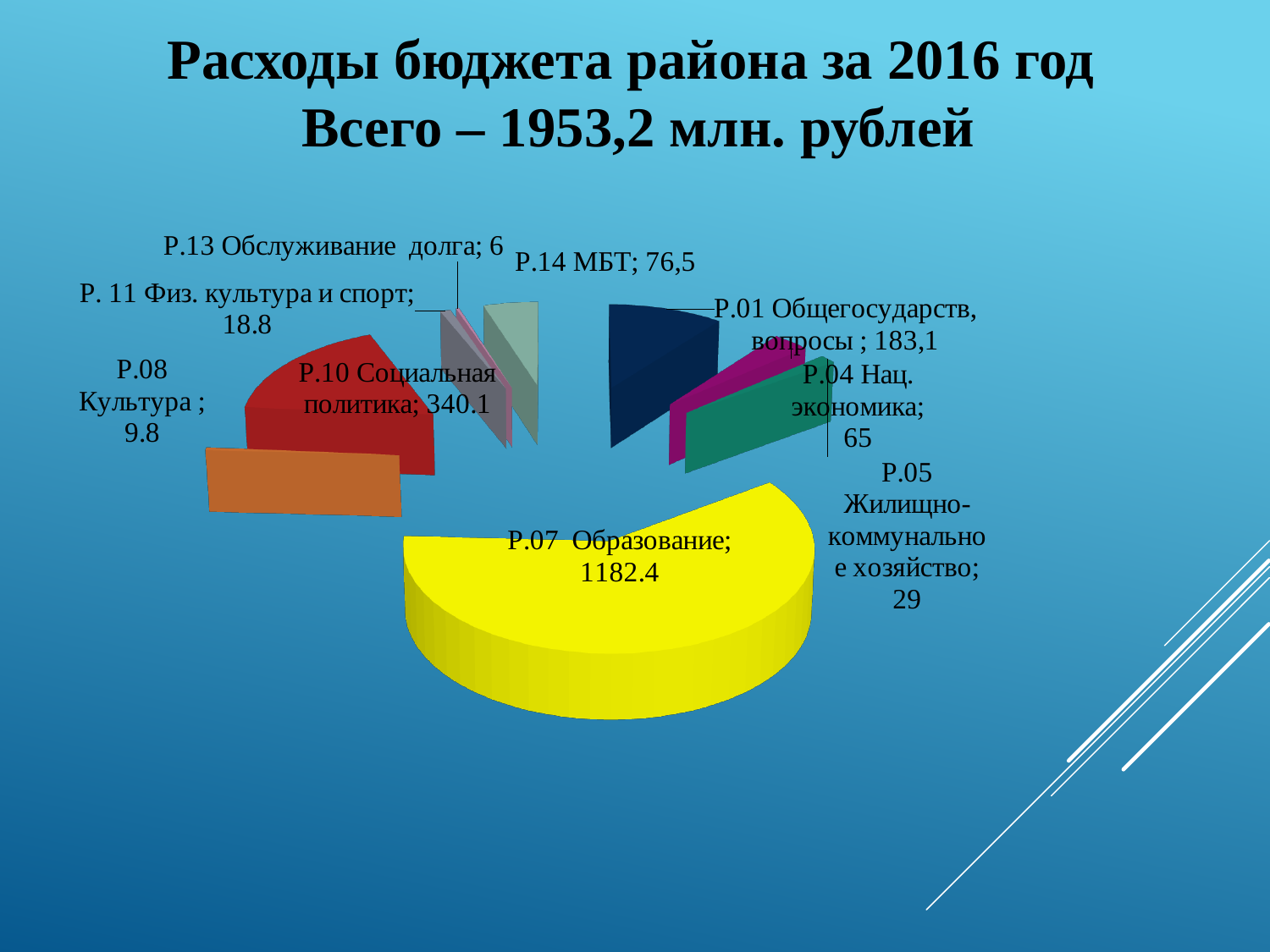
Which category has the smallest value? Р.13 Обслуживание долга What type of chart is shown on the slide? pie chart Which category has the largest slice of the pie? Р.07 Образование What is the value for Р.07 Образование? 1182.4 What is the difference between the values for Р.04 Нац. экономика and Р.05 Жилищно-коммунальное хозяйство? 36 What is the difference between the values for Р.07 Образование and Р.10 Социальная политика? 842.3 What is the value for Р.05 Жилищно-коммунальное хозяйство? 29 What is the value for Р.01 Общегосударств. вопросы? 183,1 Which is larger, the value for Р.11 Физ. культура и спорт or Р.08 Культура? Р.11 Физ. культура и спорт How many categories are shown in the pie chart? 9 What is the value for Р.10 Социальная политика? 340.1 What is the value for Р.14 МБТ? 76,5